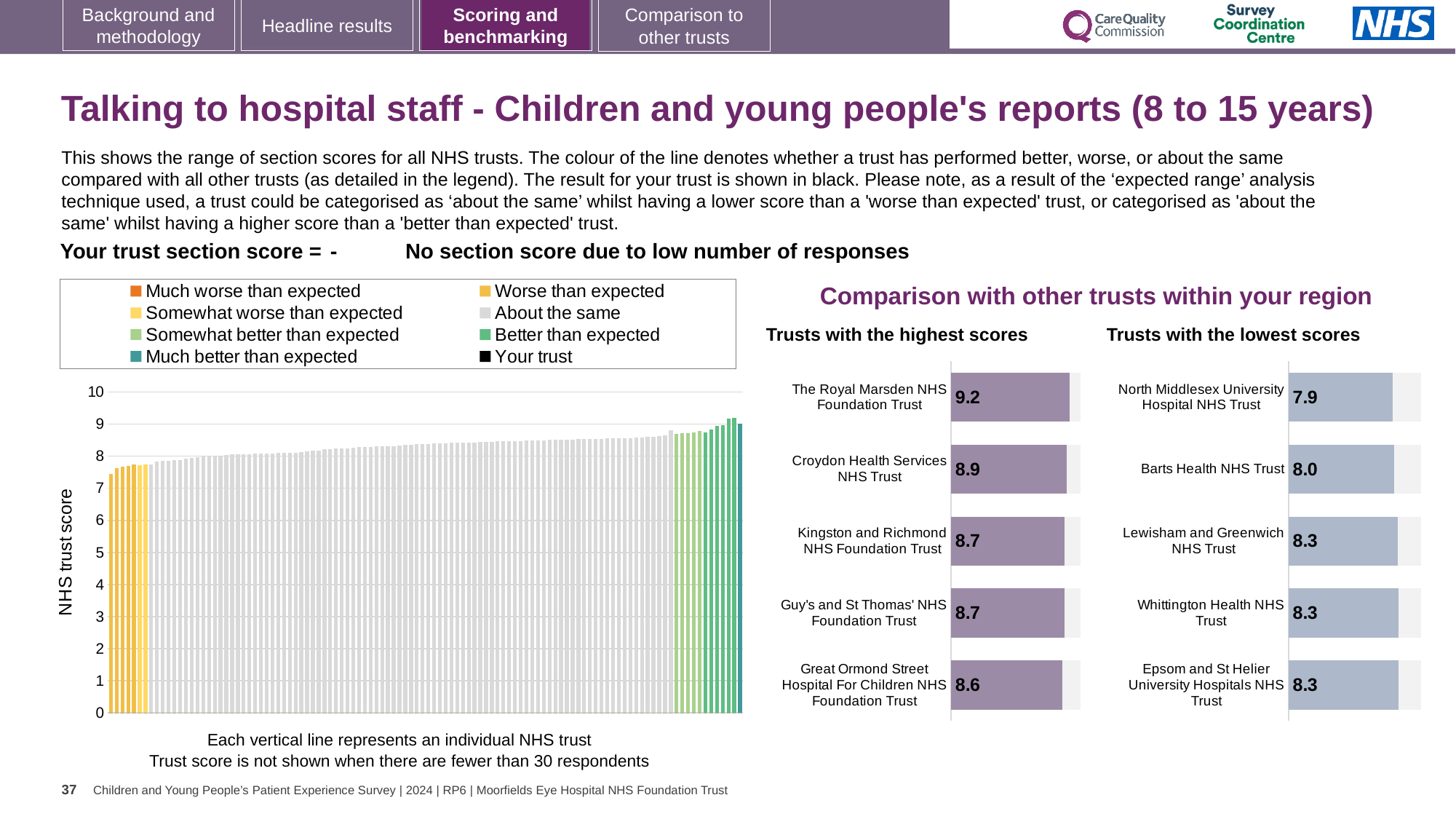
In the 'Trusts with the lowest scores' chart, which trust has the lowest score? North Middlesex University Hospital NHS Trust How many entries does the legend of the large chart on the left list? 8 What is the y-axis label of the large chart on the left? NHS trust score In the 'Trusts with the highest scores' chart, which trust has the highest score? The Royal Marsden NHS Foundation Trust In the 'Trusts with the highest scores' chart, what is the score for The Royal Marsden NHS Foundation Trust? 9.2 How many trusts are listed in the 'Trusts with the highest scores' chart? 5 In the 'Trusts with the lowest scores' chart, what is the difference between the scores of Barts Health NHS Trust and North Middlesex University Hospital NHS Trust? 0.1 In the 'Trusts with the highest scores' chart, which has the higher score: Croydon Health Services NHS Trust or Great Ormond Street Hospital For Children NHS Foundation Trust? Croydon Health Services NHS Trust In the 'Trusts with the highest scores' chart, what is the difference between the scores of The Royal Marsden NHS Foundation Trust and Croydon Health Services NHS Trust? 0.3 In the 'Trusts with the lowest scores' chart, what is the score for Lewisham and Greenwich NHS Trust? 8.3 What kind of chart is the large chart on the left showing NHS trust scores? Bar chart In the 'Trusts with the lowest scores' chart, what is the score for Barts Health NHS Trust? 8.0